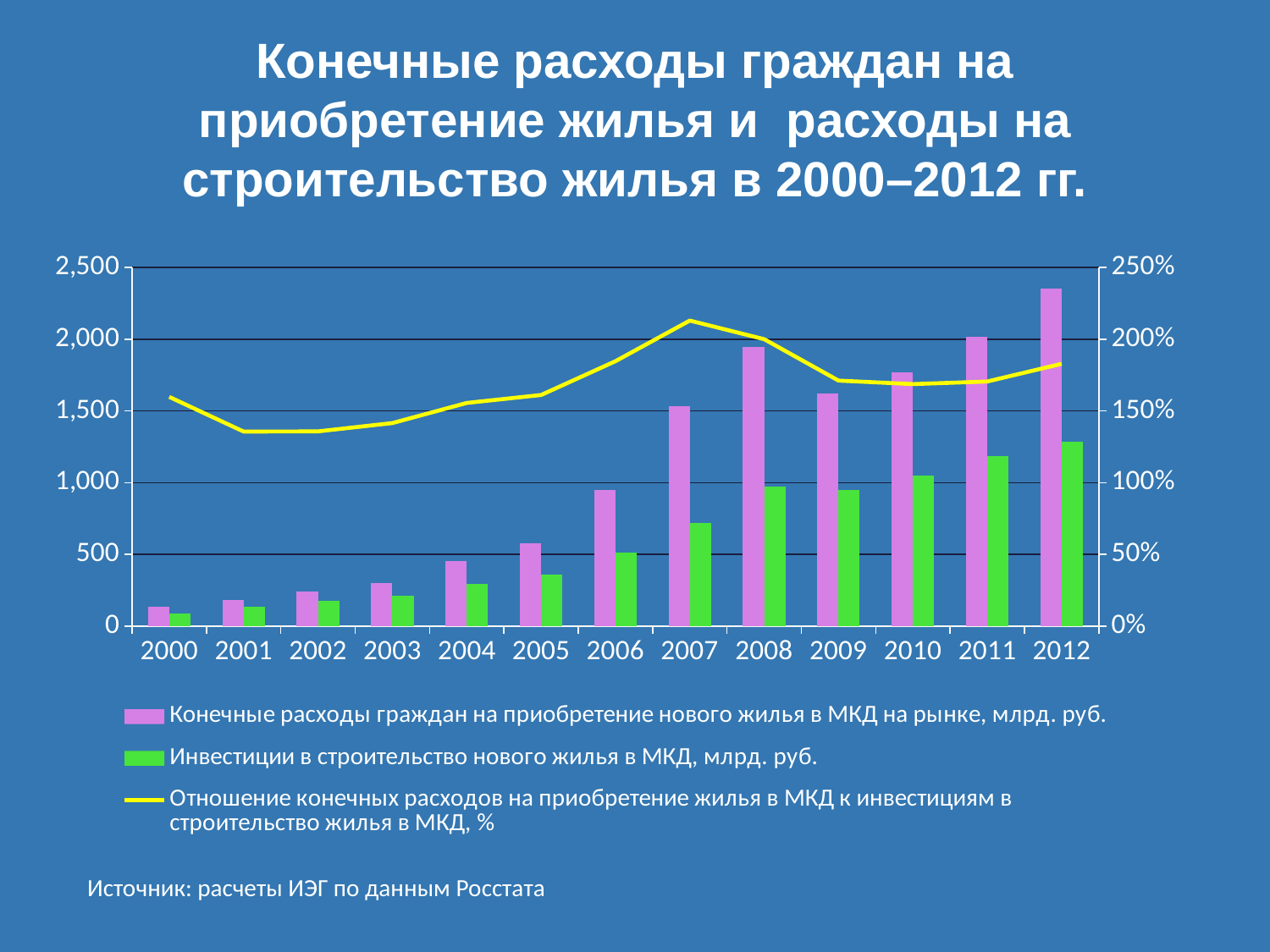
Which year has the larger bar for 'Конечные расходы граждан на приобретение нового жилья в МКД на рынке': 2008 or 2009? 2008 How many years are shown along the x axis of the chart? 13 In which year does the line 'Отношение конечных расходов на приобретение жилья в МКД к инвестициям в строительство жилья в МКД, %' reach its peak? 2007 Is the value of 'Инвестиции в строительство нового жилья в МКД' for 2012 greater or less than 1,500? less Do the bars for 'Конечные расходы граждан на приобретение нового жилья в МКД на рынке' rise or fall from 2000 to 2008? rise What colour are the bars for 'Инвестиции в строительство нового жилья в МКД, млрд. руб.'? green In which year is the bar for 'Конечные расходы граждан на приобретение нового жилья в МКД на рынке, млрд. руб.' the highest? 2012 How many series does the chart's legend list? 3 Is the ratio line value for 2007 greater or less than 200%? greater In which year is the bar for 'Инвестиции в строительство нового жилья в МКД, млрд. руб.' the lowest? 2000 Is the value of 'Конечные расходы граждан на приобретение нового жилья в МКД на рынке' for 2012 greater or less than 2,000? greater What kind of chart is shown on the slide? A bar chart combined with a line